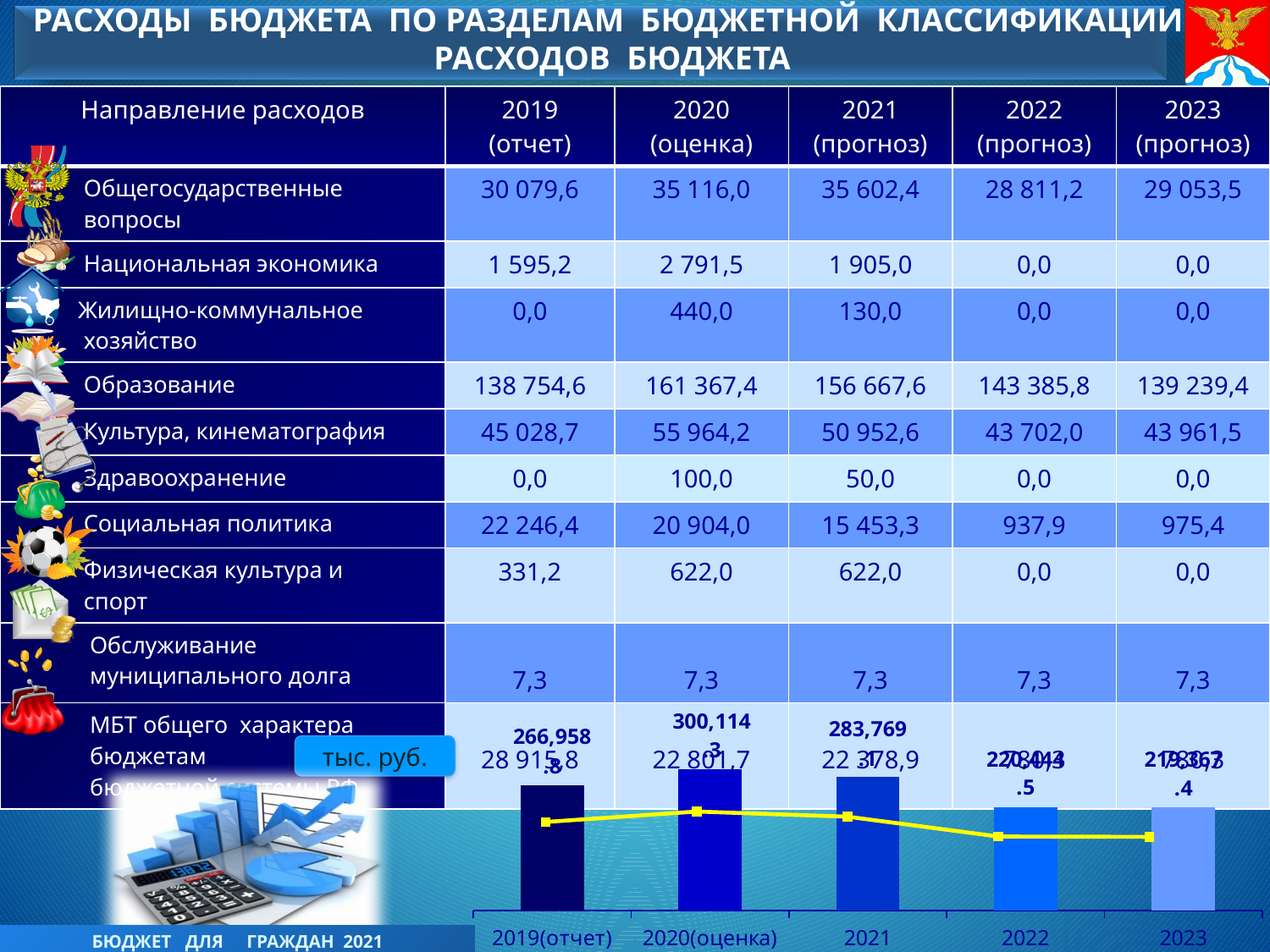
In the chart, which bar is taller: 2019(отчет) or 2022? 2019(отчет) How many years (categories) are plotted on the x axis of the chart? 5 What is the value labelled on the bar for 2020(оценка) in the chart? 300,114.3 What is the value labelled on the bar for 2019(отчет) in the chart? 266,958.8 Which year has the tallest bar in the chart? 2020(оценка) In the chart, which bar is taller: 2020(оценка) or 2021? 2020(оценка) Do the bar values rise or fall from 2020(оценка) to 2023 in the chart? fall What is the label of the first category on the chart's x axis? 2019(отчет) What is the difference between the 2020(оценка) and 2019(отчет) values in the chart? 33,155.5 What kind of chart is shown at the bottom of the slide? bar chart What unit is indicated in the label next to the chart? тыс. руб. In the chart, which bar is taller: 2019(отчет) or 2021? 2021